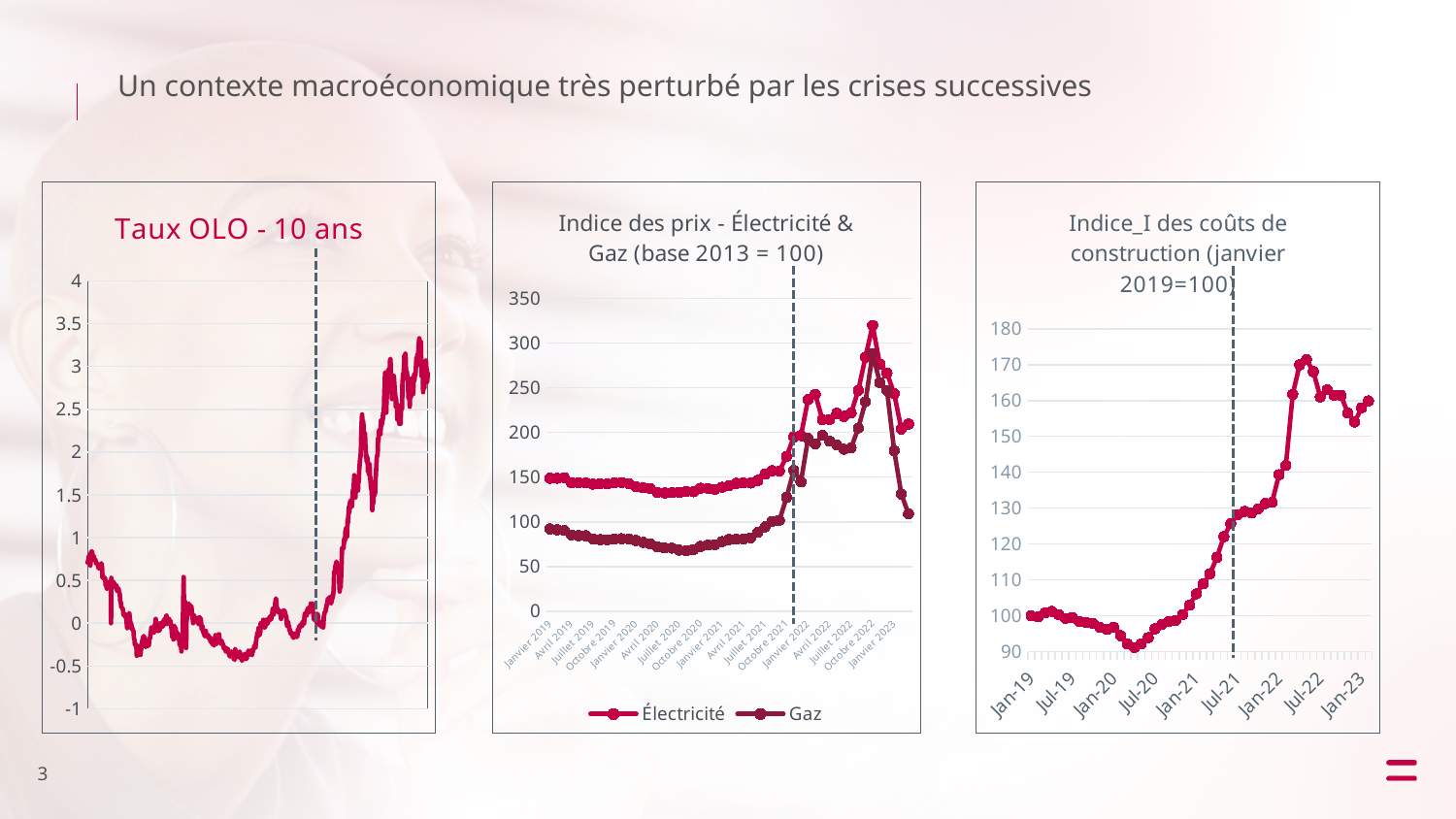
In the 'Taux OLO - 10 ans' chart, is the value at the end of the series (right side) greater or less than 2? greater What are the two series named in the legend of the 'Indice des prix - Électricité & Gaz' chart? Électricité and Gaz In the 'Indice_I des coûts de construction' chart, is the value at Jul-20 greater or less than 100? less In the 'Indice des prix - Électricité & Gaz' chart, is the peak value of the Électricité series greater or less than 300? greater In the 'Taux OLO - 10 ans' chart, do the values overall rise or fall from the start to the end of the series? rise What kind of chart is the 'Indice_I des coûts de construction' chart? line chart In the 'Indice des prix - Électricité & Gaz' chart, which series is higher in Janvier 2019, Électricité or Gaz? Électricité How many series does the legend of the 'Indice des prix - Électricité & Gaz' chart list? 2 What kind of chart is the 'Taux OLO - 10 ans' chart? line chart